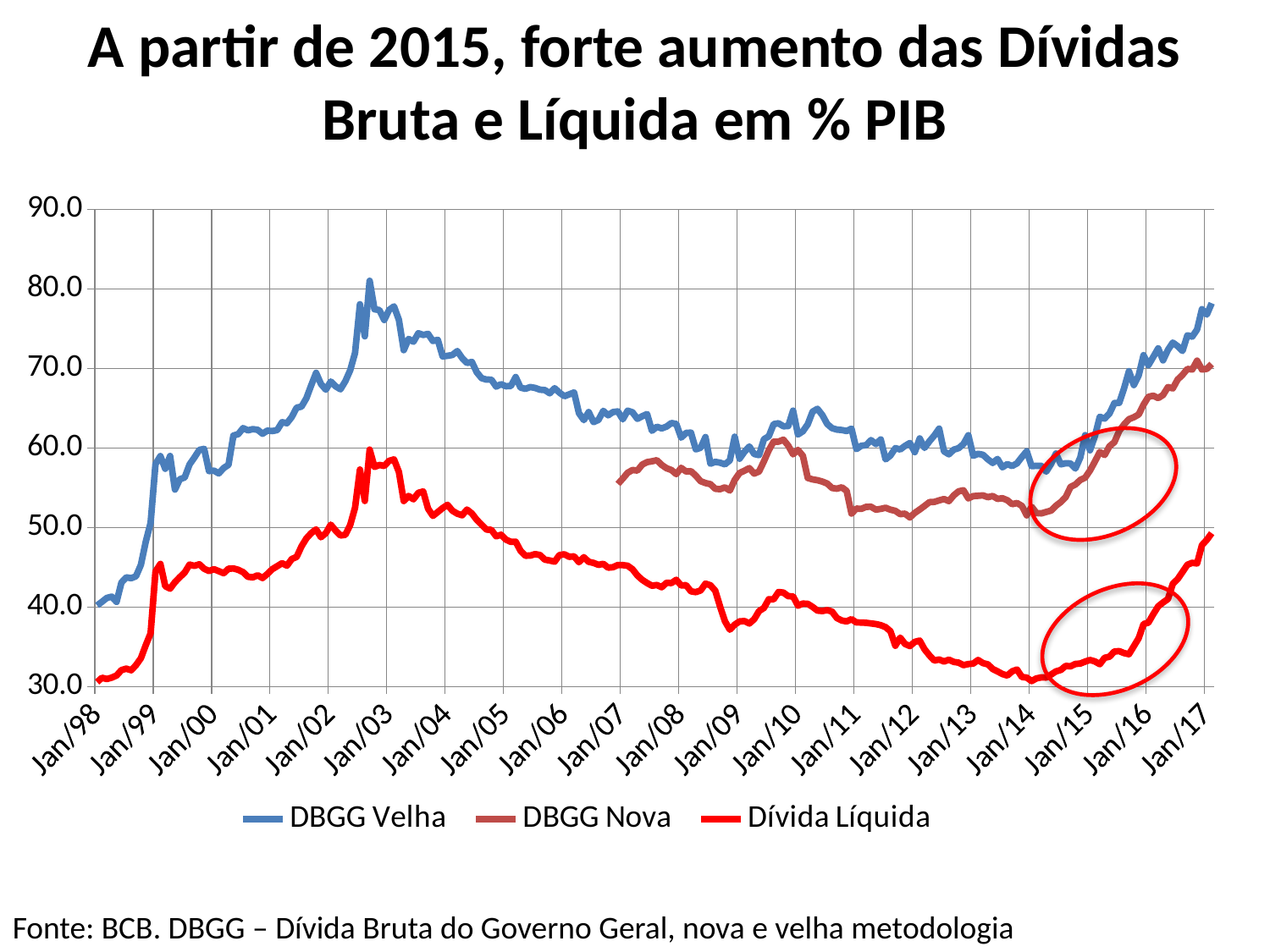
Which series has the highest value at Jan/17? DBGG Velha What kind of chart is shown on the slide? line chart Is the value of DBGG Velha at Jan/98 greater or less than 50? less Is the value of DBGG Velha at Jan/03 greater or less than 70? greater What are the three series named in the legend? DBGG Velha, DBGG Nova, Dívida Líquida Is the value of Dívida Líquida at Jan/14 greater or less than 40? less How many series does the legend list? 3 At Jan/17, which series is higher: DBGG Velha or Dívida Líquida? DBGG Velha Which series starts latest on the x axis, with no data before about Jan/07? DBGG Nova Does Dívida Líquida rise or fall between Jan/14 and Jan/17? rise How many year labels are shown on the x axis, from Jan/98 to Jan/17? 20